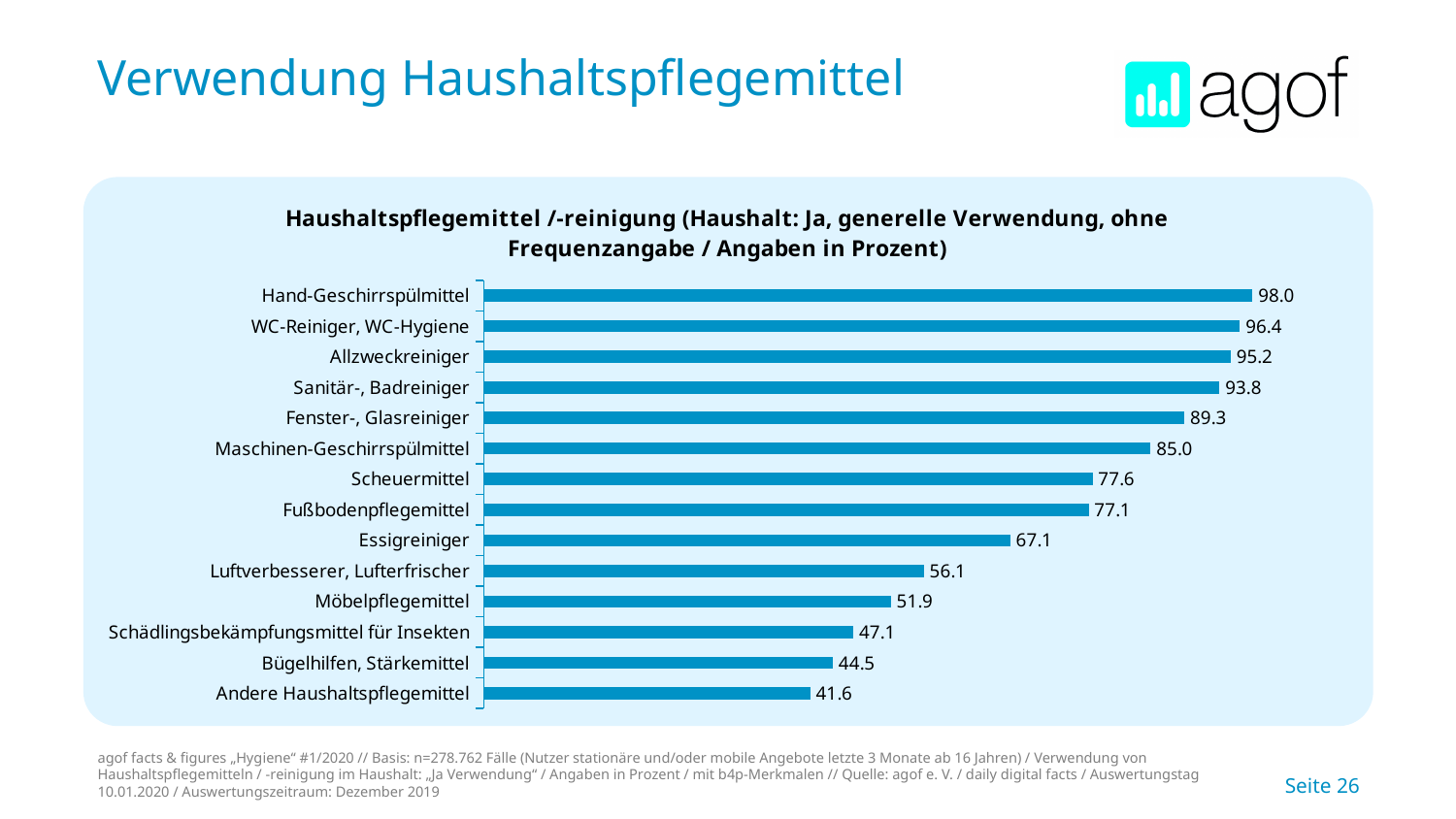
What is the value for Schädlingsbekämpfungsmittel für Insekten? 47.1 What is the difference between the values for Hand-Geschirrspülmittel and Andere Haushaltspflegemittel? 56.4 Which category has the highest value? Hand-Geschirrspülmittel Which category has the lowest value? Andere Haushaltspflegemittel Which is larger, the value for Möbelpflegemittel or the value for Luftverbesserer, Lufterfrischer? Luftverbesserer, Lufterfrischer What is the value for Bügelhilfen, Stärkemittel? 44.5 What is the title of the chart? Haushaltspflegemittel /-reinigung (Haushalt: Ja, generelle Verwendung, ohne Frequenzangabe / Angaben in Prozent) What is the value for Hand-Geschirrspülmittel? 98.0 What is the difference between the values for Maschinen-Geschirrspülmittel and Scheuermittel? 7.4 What kind of chart is shown on the slide? Bar chart How many categories are shown in the chart? 14 What is the value for Essigreiniger? 67.1